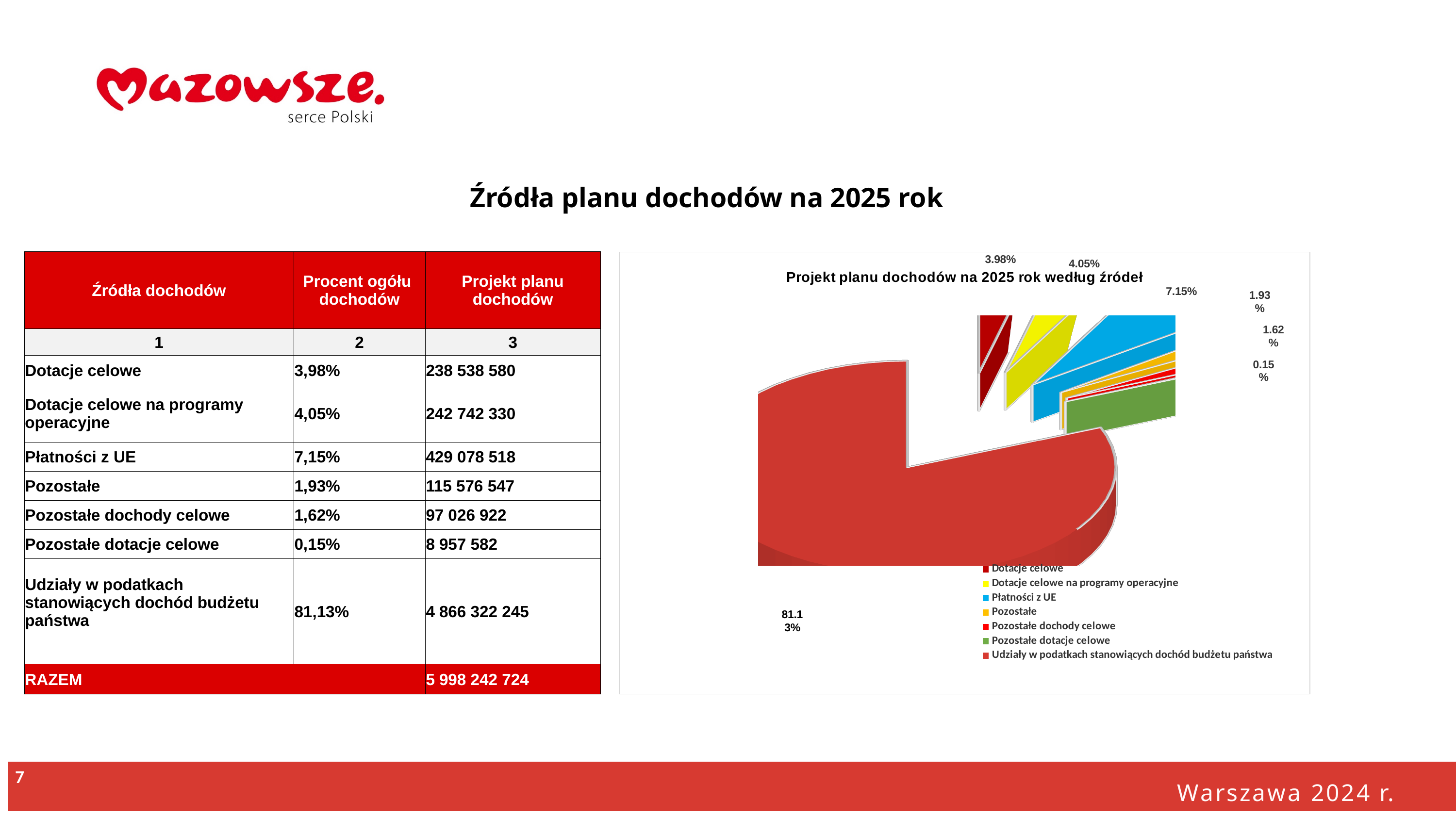
Which category has the largest slice of the pie? Udziały w podatkach stanowiących dochód budżetu państwa What is the title of the chart on the slide? Projekt planu dochodów na 2025 rok według źródeł What share of the pie does Pozostałe dotacje celowe have? 0.15% How many slices does the pie chart have? 7 What share of the pie does Udziały w podatkach stanowiących dochód budżetu państwa have? 81.13% What kind of chart is shown on the slide? pie chart Which category has the smallest slice of the pie? Pozostałe dotacje celowe Which slice is larger: Płatności z UE or Pozostałe? Płatności z UE What share of the pie does Płatności z UE have? 7.15% How many entries does the chart's legend list? 7 What colour is the Płatności z UE slice in the pie chart? blue